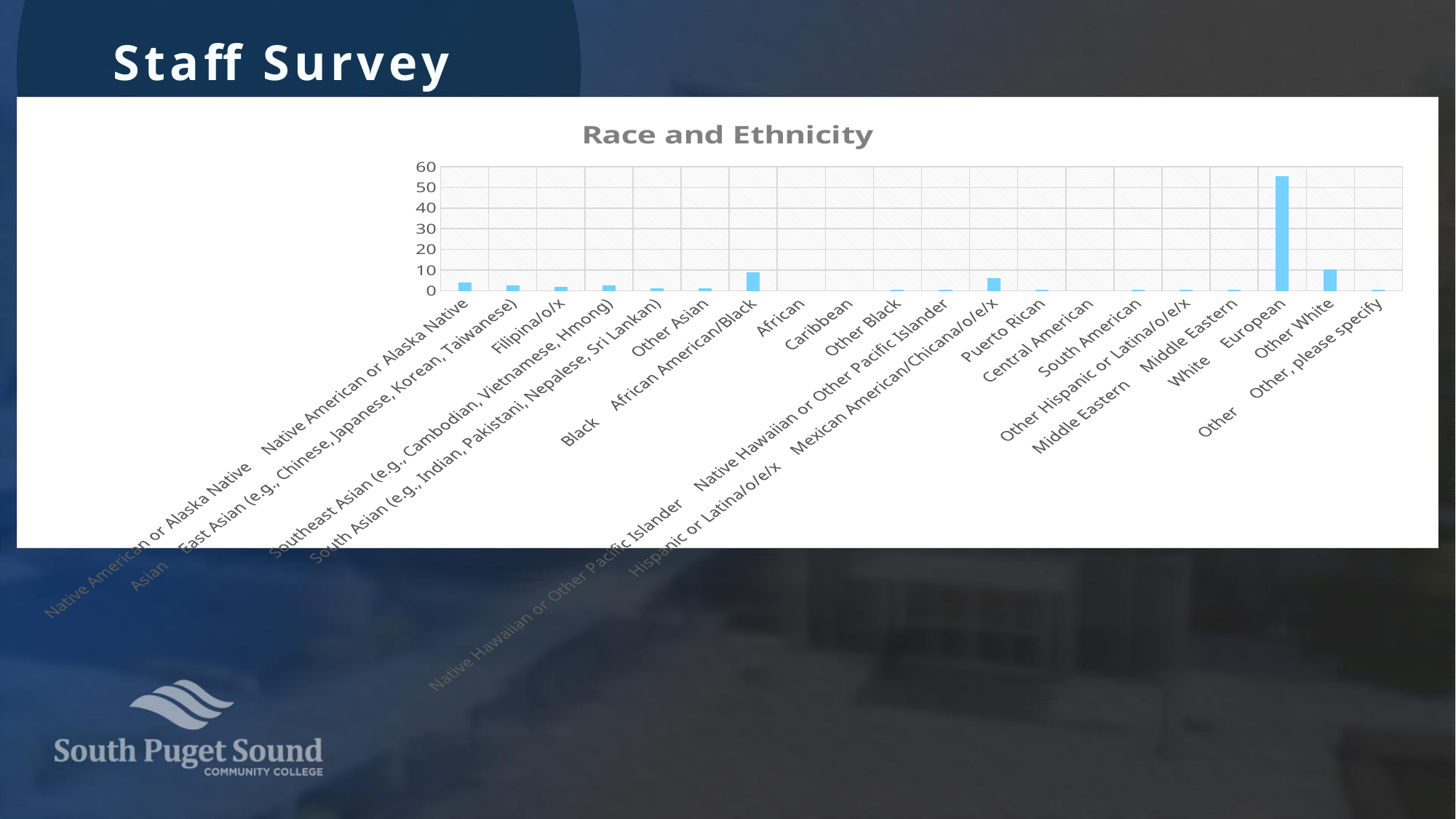
What is the title of the chart? Race and Ethnicity Which is larger, the value for European or the value for Other White? European Is the value for Mexican American/Chicana/o/e/x greater or less than 10? less Is the value for Other White greater or less than 20? less Is the value for Native American or Alaska Native greater or less than 10? less How many categories are shown on the x axis of the Race and Ethnicity chart? 20 Which category has the highest value in the Race and Ethnicity chart? European Which is larger, the value for African American/Black or the value for Mexican American/Chicana/o/e/x? African American/Black What kind of chart is shown on the slide? bar chart What is the maximum value shown on the y axis of the chart? 60